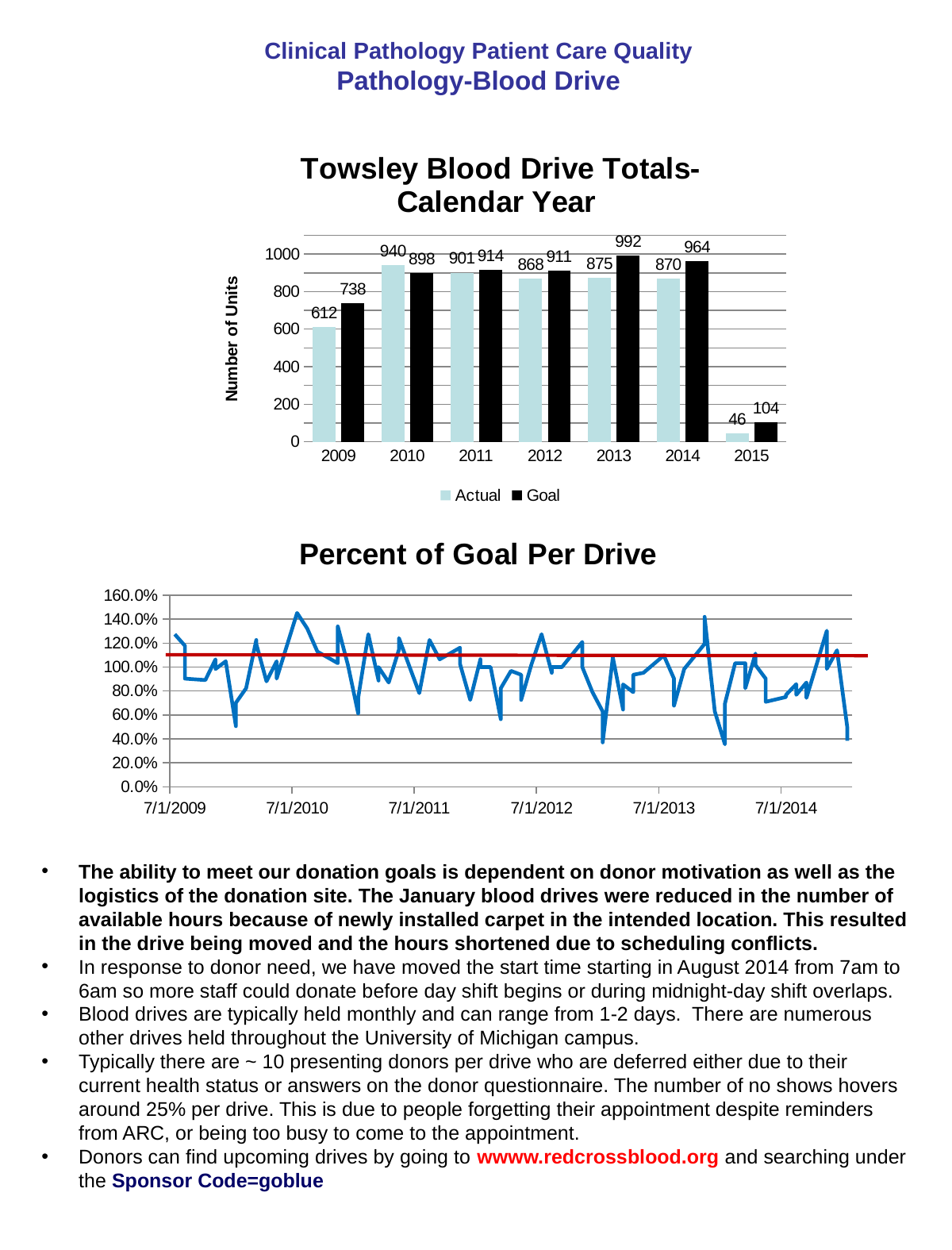
In the Towsley Blood Drive Totals-Calendar Year chart, how many years are shown on the x axis? 7 In the Towsley Blood Drive Totals-Calendar Year chart, what is the difference between the Goal and Actual values for 2009? 126 In the Towsley Blood Drive Totals-Calendar Year chart, which year has the lowest Goal value? 2015 In the Towsley Blood Drive Totals-Calendar Year chart, what is the y-axis title? Number of Units In the Towsley Blood Drive Totals-Calendar Year chart, which year has the highest Actual value? 2010 In the Towsley Blood Drive Totals-Calendar Year chart, what was the Goal for 2013? 992 In the Towsley Blood Drive Totals-Calendar Year chart, what is the difference between the Actual values for 2010 and 2011? 39 In the Towsley Blood Drive Totals-Calendar Year chart, what was the Actual number of units in 2010? 940 What kind of chart is the Percent of Goal Per Drive chart? Line chart In the Towsley Blood Drive Totals-Calendar Year chart, which is larger for 2014, the Actual or the Goal? Goal What kind of chart is the Towsley Blood Drive Totals-Calendar Year chart? Bar chart In the Towsley Blood Drive Totals-Calendar Year chart, how many series does the legend list? 2